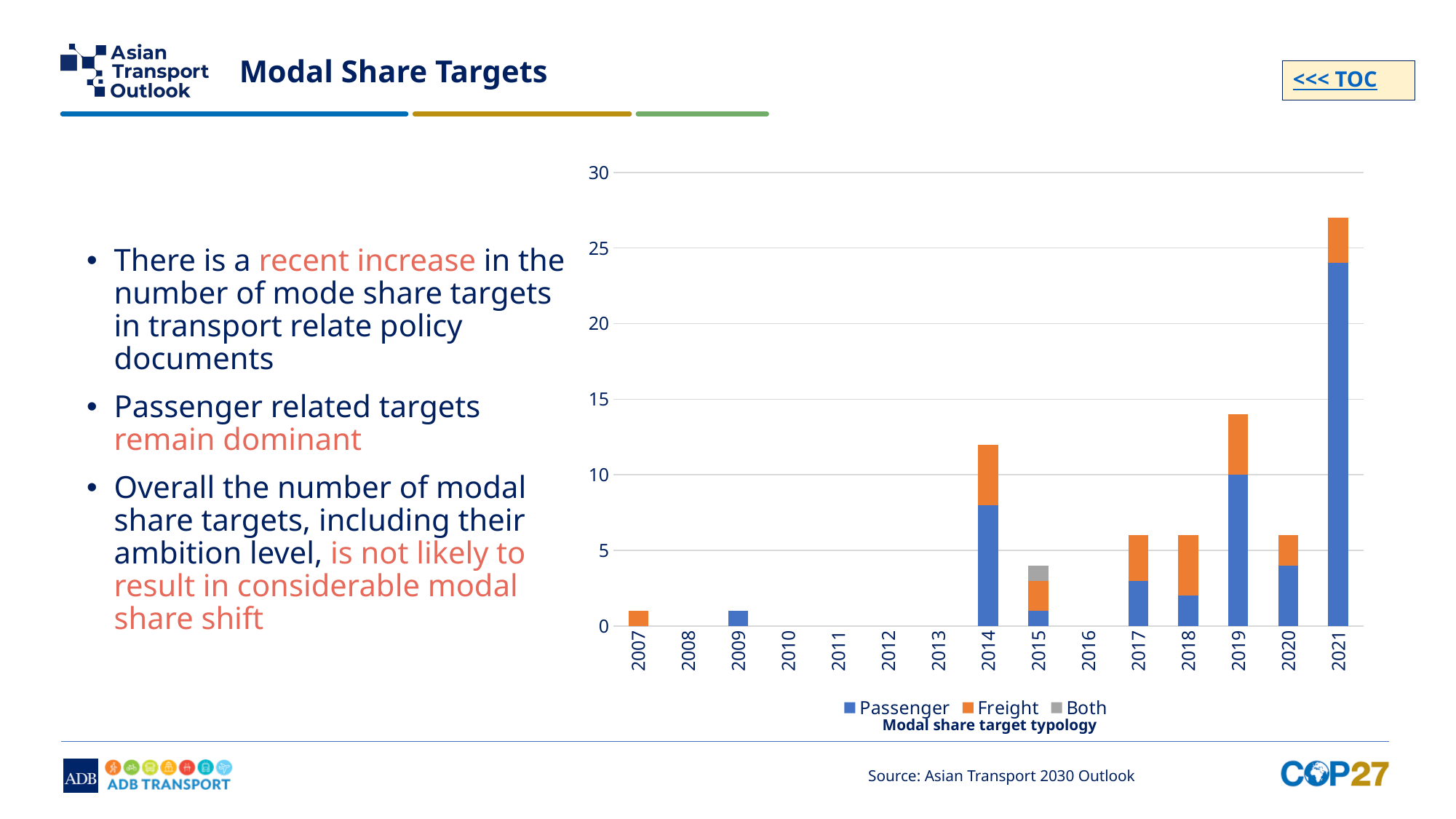
Is the total height of the 2015 bar greater or less than 5? less Which year has the taller stacked bar, 2014 or 2019? 2019 What kind of chart is shown on the slide? bar chart How many series does the chart legend list? 3 Is the total height of the 2014 bar greater or less than 10? greater Is the Passenger segment for 2021 greater or less than 20? greater What colour represents the Freight series in the chart? orange How many years are shown on the x axis of the chart? 15 Which year has the tallest stacked bar in the chart? 2021 Do the bar heights generally rise or fall from 2007 to 2021? rise Which series are listed in the chart legend? Passenger, Freight, Both